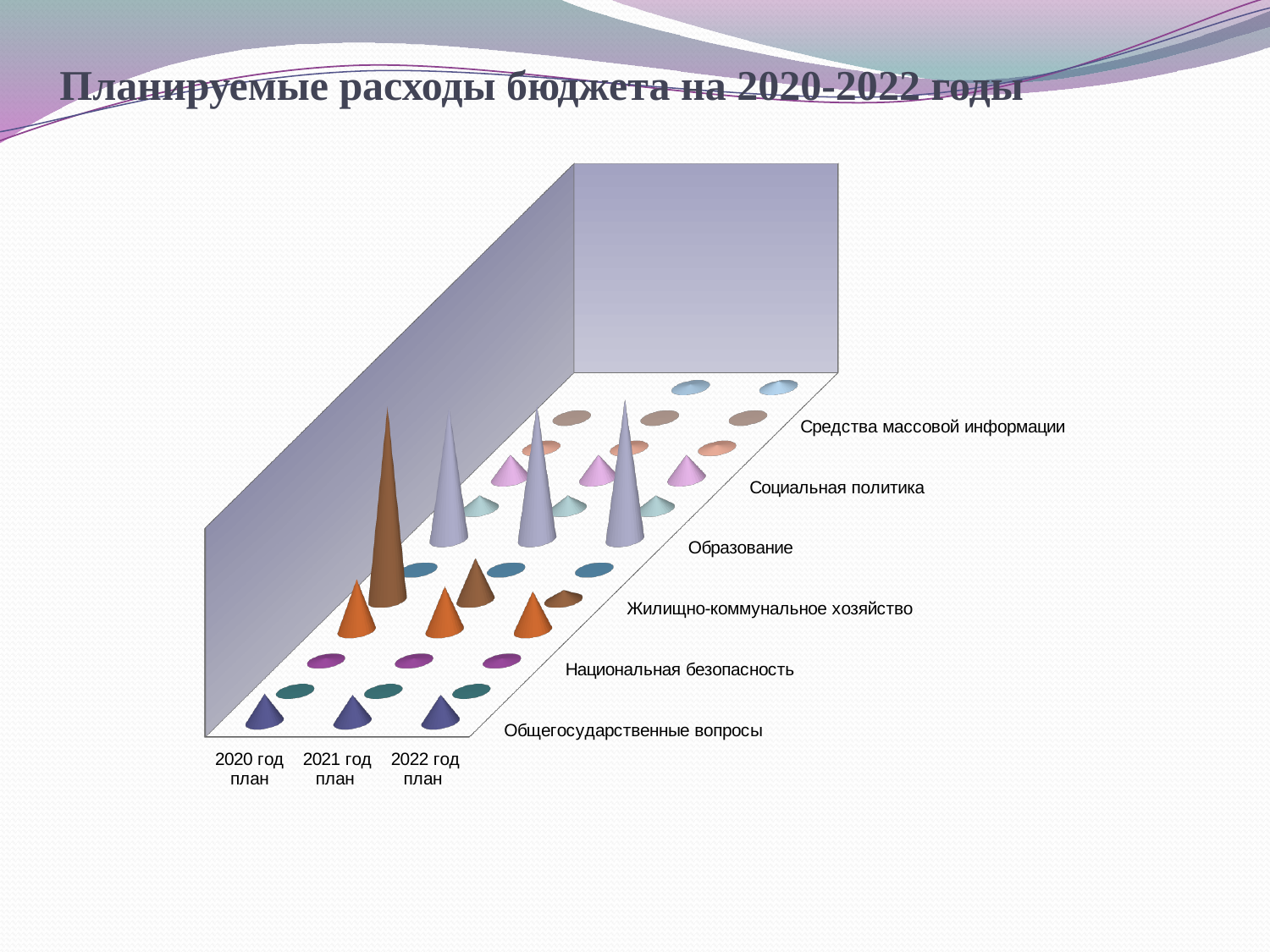
Which year category is listed first on the x axis of the chart? 2020 год план Which labelled expenditure category has the highest value for 2021 год план? Образование What is the title of the chart on the slide? Планируемые расходы бюджета на 2020-2022 годы How many year categories are shown along the x axis of the chart? 3 What kind of chart is shown on the slide? bar chart Which labelled expenditure category has the highest value for 2022 год план? Образование In which year category is the value for Жилищно-коммунальное хозяйство highest? 2020 год план In which year category is the value for Жилищно-коммунальное хозяйство lowest? 2022 год план Which is larger for Жилищно-коммунальное хозяйство: the value for 2020 год план or for 2022 год план? 2020 год план Which is larger for 2022 год план: the value for Образование or for Общегосударственные вопросы? Образование Do the values for Жилищно-коммунальное хозяйство rise or fall from 2020 год план to 2022 год план? fall